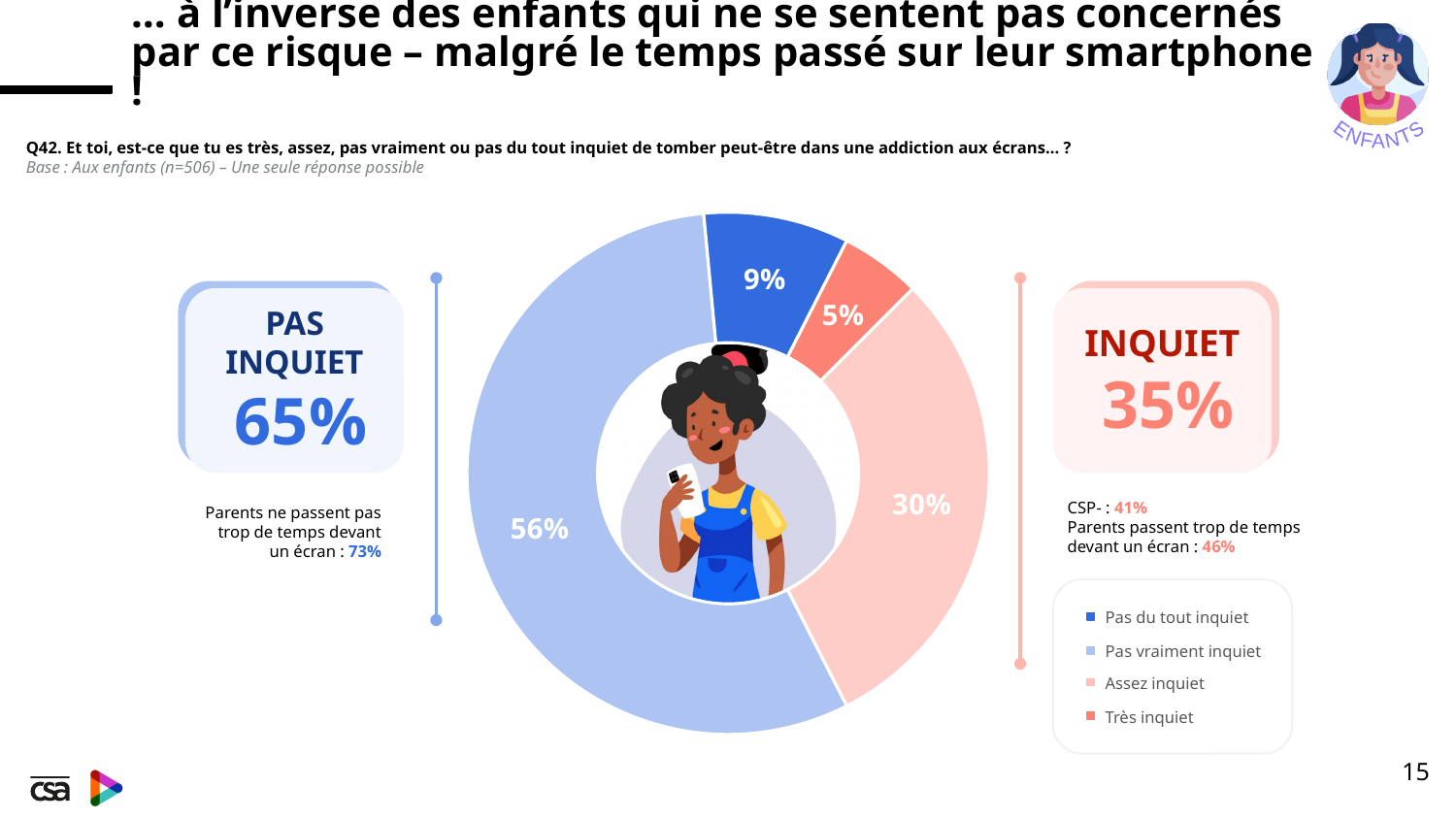
What is the difference between the "Pas vraiment inquiet" share and the "Assez inquiet" share? 26 points What share of children answered "Assez inquiet"? 30% How many slices does the donut chart have? 4 What share of children answered "Pas du tout inquiet"? 9% Which response category has the smallest slice of the donut chart? Très inquiet How many entries does the legend list? 4 What share of children answered "Très inquiet"? 5% Which response category has the largest slice of the donut chart? Pas vraiment inquiet What is the combined share of children who are "Inquiet" (Assez inquiet plus Très inquiet)? 35% What kind of chart is shown on the slide? Donut (pie) chart Which is larger: the "Pas du tout inquiet" share or the "Très inquiet" share? Pas du tout inquiet What share of children answered "Pas vraiment inquiet"? 56%